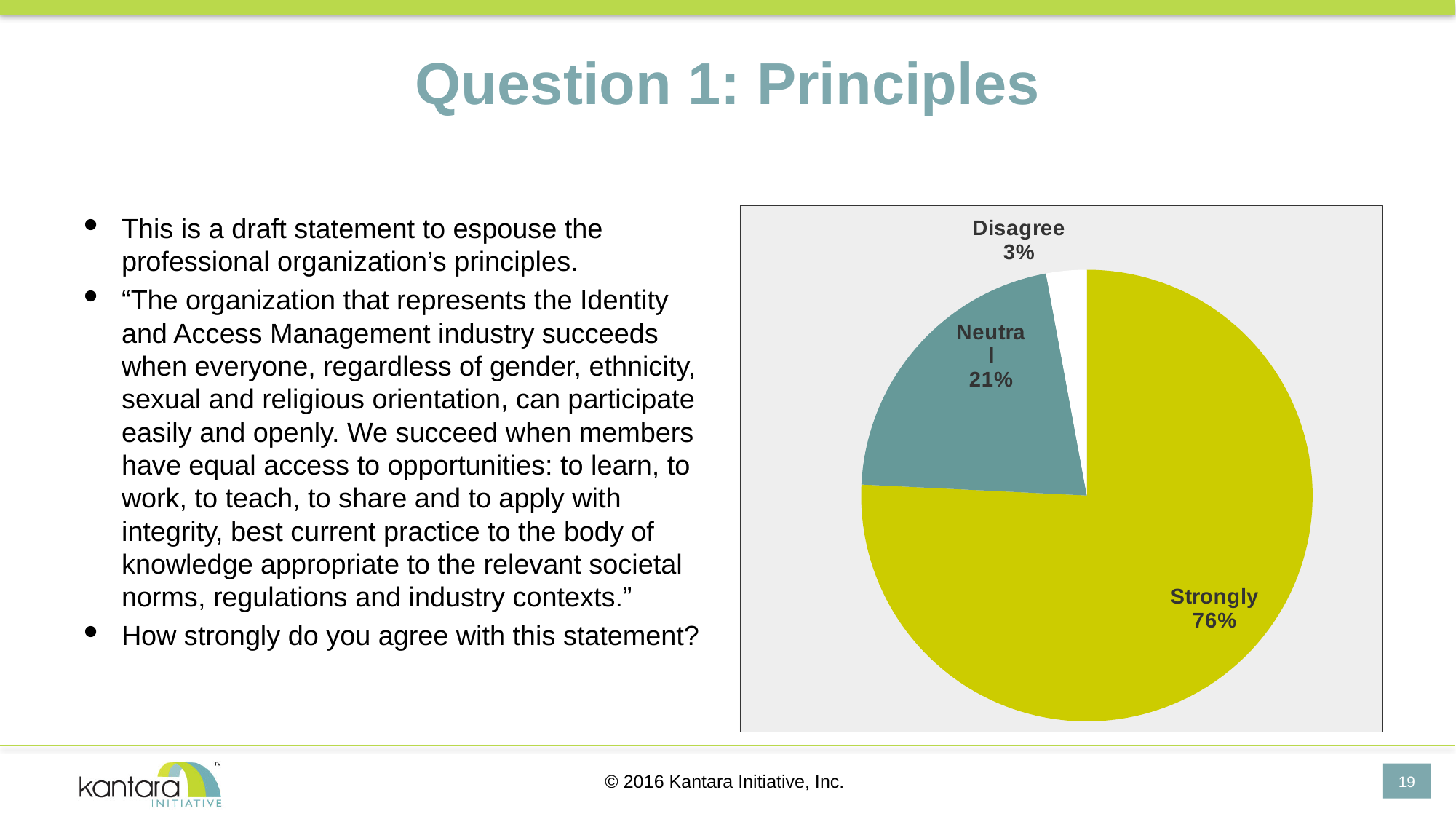
Which slice of the pie chart is the largest? Strongly Which slice of the pie chart is the smallest? Disagree How many slices does the pie chart have? 3 What share of the pie is labelled Neutral? 21% Which is larger, the Neutral slice or the Disagree slice? Neutral What colour is the Neutral slice of the pie chart? teal What colour is the Strongly slice of the pie chart? yellow-green What share of the pie is labelled Strongly? 76% What is the difference in percentage points between the Neutral and Disagree slices? 18 What kind of chart is shown on the slide? pie chart What share of the pie is labelled Disagree? 3% What is the difference in percentage points between the Strongly and Neutral slices? 55